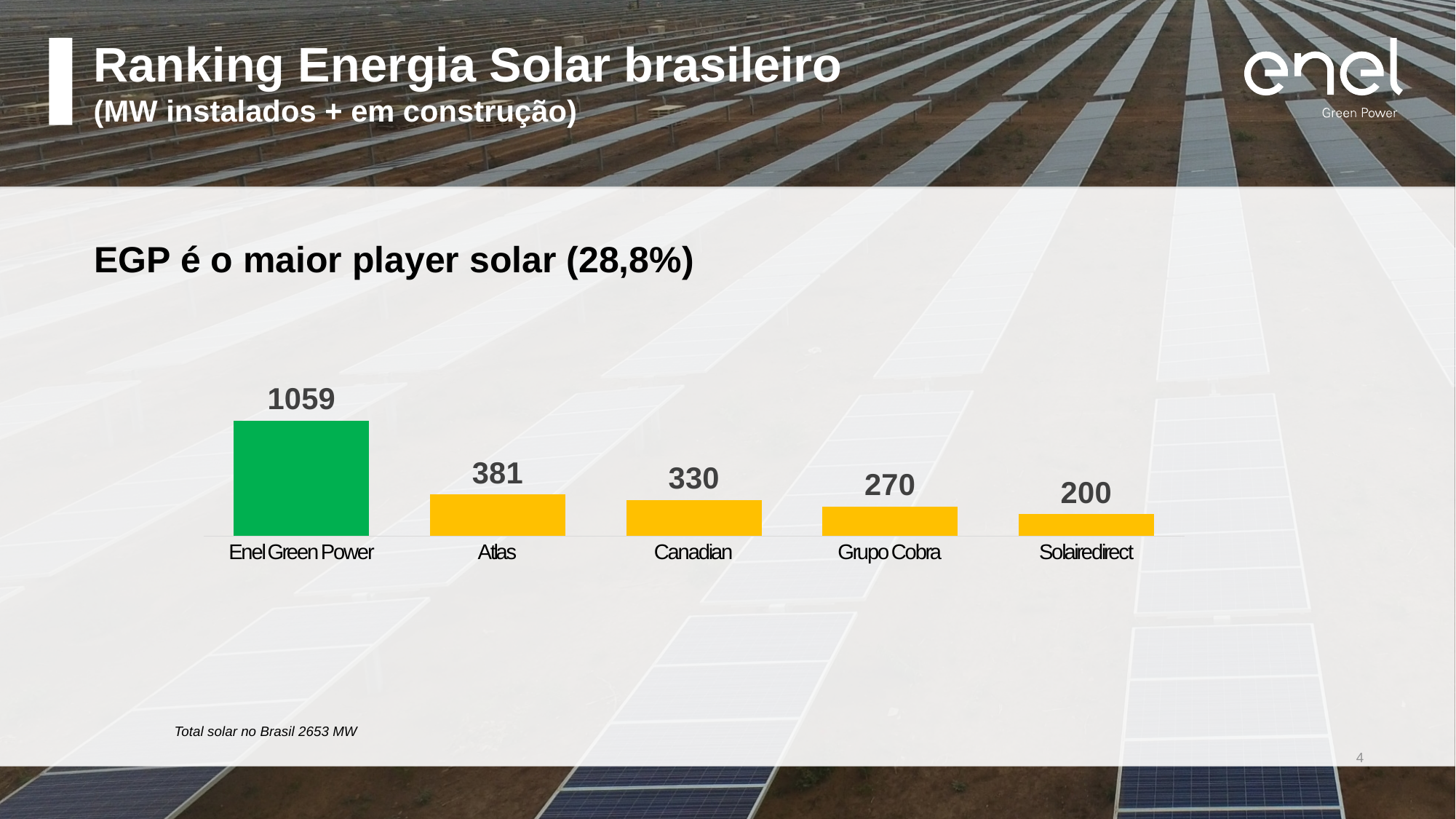
What is the value shown for Solairedirect? 200 What type of chart is shown on the slide? Bar chart What is the value shown for Atlas? 381 What is the value shown for Enel Green Power? 1059 What is the difference between the values for Canadian and Grupo Cobra? 60 What is the difference between the values for Enel Green Power and Atlas? 678 Which company has the highest value in the chart? Enel Green Power Which company has the lowest value in the chart? Solairedirect What is the value shown for Grupo Cobra? 270 What is the value shown for Canadian? 330 How many companies are shown in the chart? 5 Which has a larger value, Atlas or Canadian? Atlas